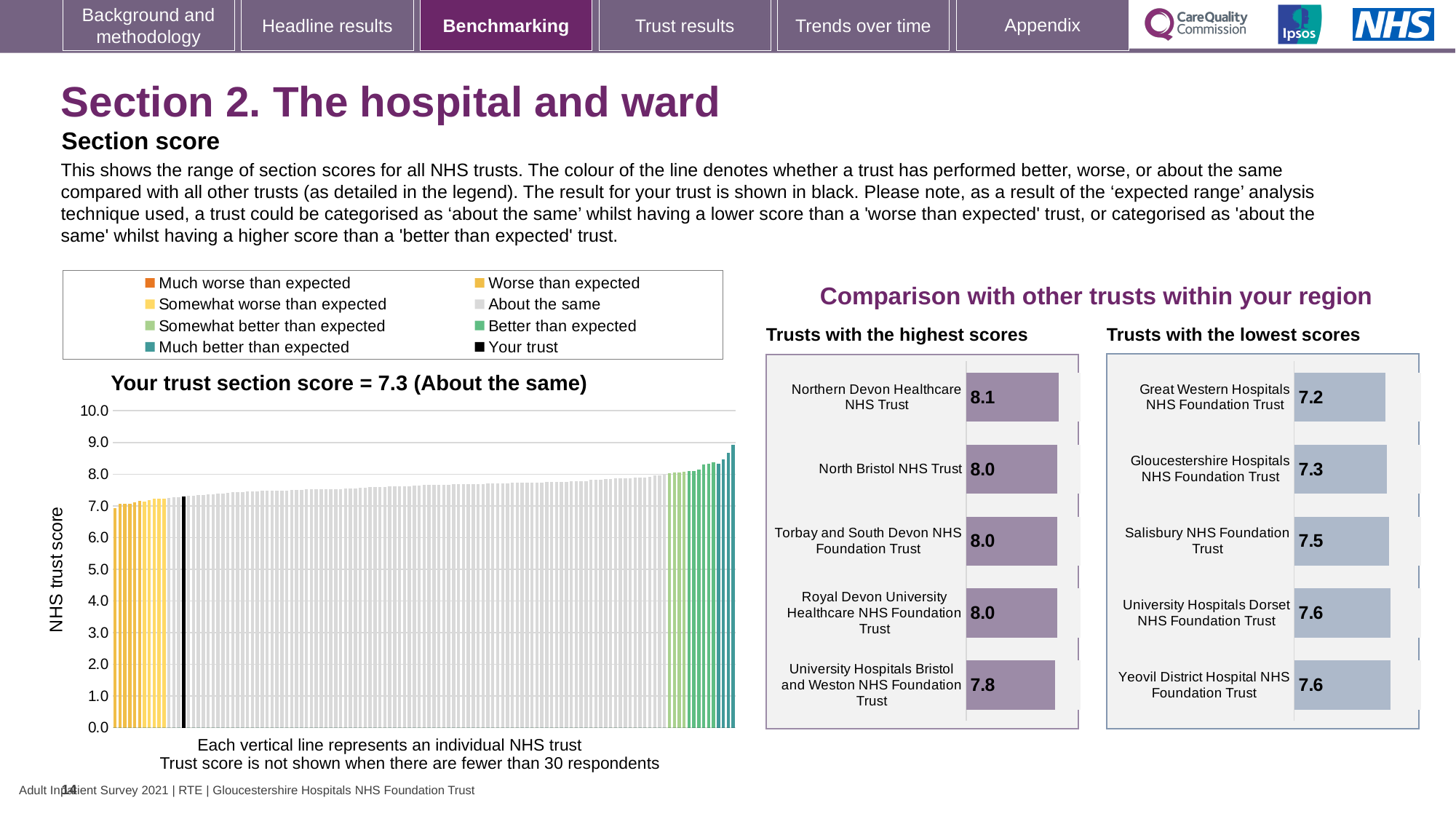
In the 'Trusts with the lowest scores' chart, which trust has the lowest score? Great Western Hospitals NHS Foundation Trust In the 'Trusts with the highest scores' chart, what is the score for University Hospitals Bristol and Weston NHS Foundation Trust? 7.8 In the 'Your trust section score' chart, do the trust scores rise or fall from left to right along the x axis? rise In the 'Trusts with the highest scores' chart, how many trusts are shown? 5 In the 'Your trust section score' chart, which category is your trust placed in? About the same In the 'Trusts with the highest scores' chart, which trust has the highest score? Northern Devon Healthcare NHS Trust In the 'Your trust section score' chart, how many entries does the legend list? 8 In the 'Trusts with the lowest scores' chart, which has the larger score, Salisbury NHS Foundation Trust or Gloucestershire Hospitals NHS Foundation Trust? Salisbury NHS Foundation Trust In the 'Trusts with the lowest scores' chart, what is the score for Salisbury NHS Foundation Trust? 7.5 In the 'Your trust section score' chart, what is the section score for your trust? 7.3 In the 'Your trust section score' chart, what kind of chart is used to show the trust scores? bar chart In the 'Trusts with the highest scores' chart, what is the difference between the scores of Northern Devon Healthcare NHS Trust and University Hospitals Bristol and Weston NHS Foundation Trust? 0.3